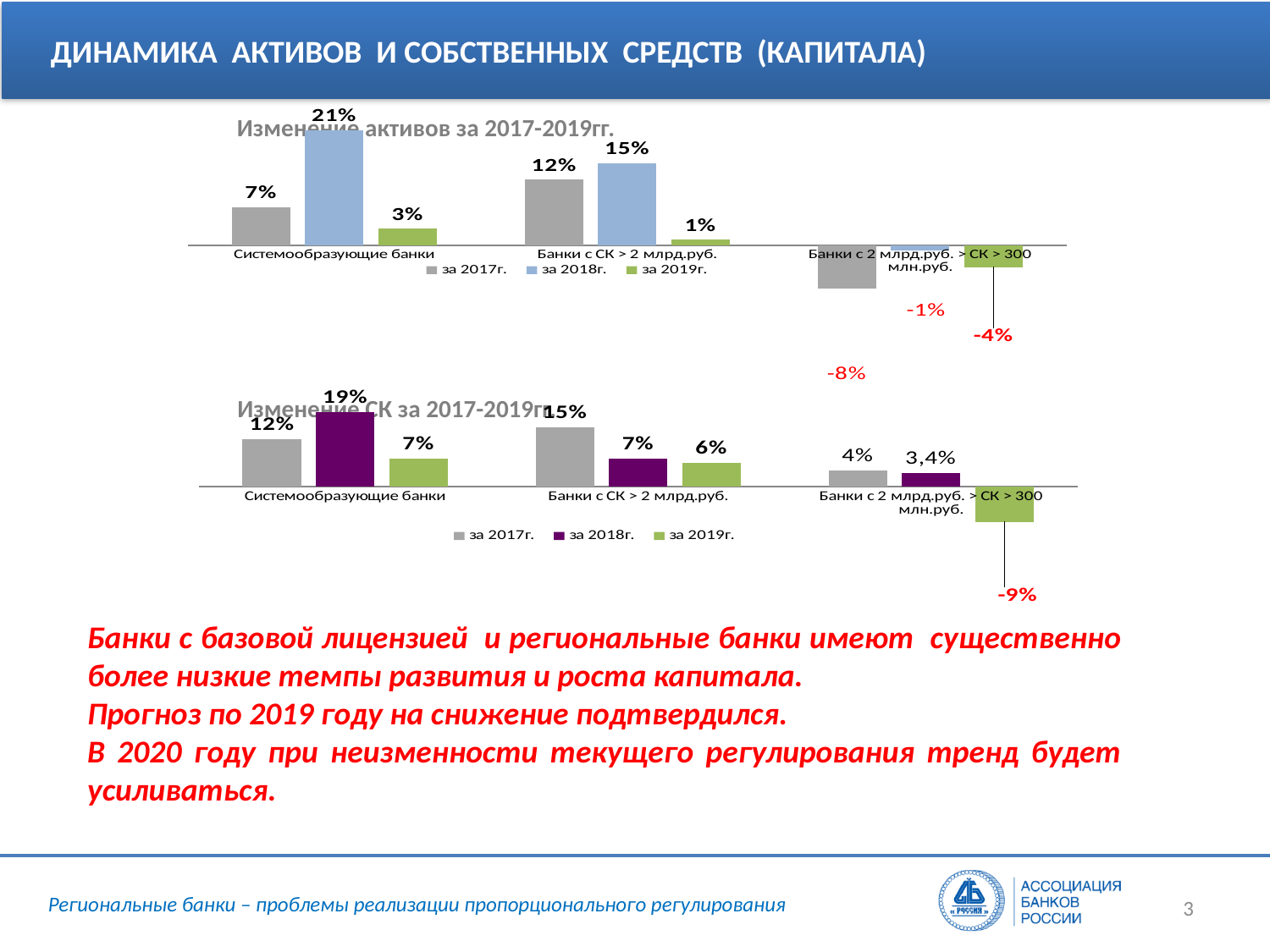
In the chart 'Изменение СК за 2017-2019гг.', which is larger for Банки с СК > 2 млрд.руб.: the за 2017г. value or the за 2018г. value? за 2017г. In the chart 'Изменение СК за 2017-2019гг.', what is the value for Системообразующие банки for за 2019г.? 7% What kind of chart is 'Изменение активов за 2017-2019гг.'? Bar chart In the chart 'Изменение СК за 2017-2019гг.', which category has the lowest value for за 2019г.? Банки с 2 млрд.руб. > СК > 300 млн.руб. In the chart 'Изменение активов за 2017-2019гг.', what is the value for Банки с 2 млрд.руб. > СК > 300 млн.руб. for за 2017г.? -8% In the chart 'Изменение активов за 2017-2019гг.', what is the value for Системообразующие банки for за 2018г.? 21% In the chart 'Изменение СК за 2017-2019гг.', what is the value for Банки с 2 млрд.руб. > СК > 300 млн.руб. for за 2018г.? 3,4% In the chart 'Изменение активов за 2017-2019гг.', what is the difference between the за 2018г. and за 2017г. values for Системообразующие банки? 14% In the chart 'Изменение СК за 2017-2019гг.', what is the difference between the за 2017г. and за 2019г. values for Системообразующие банки? 5% In the chart 'Изменение активов за 2017-2019гг.', what is the value for Банки с СК > 2 млрд.руб. for за 2019г.? 1% In the chart 'Изменение активов за 2017-2019гг.', which category has the highest value for за 2017г.? Банки с СК > 2 млрд.руб. How many series does the legend of the chart 'Изменение СК за 2017-2019гг.' list? 3